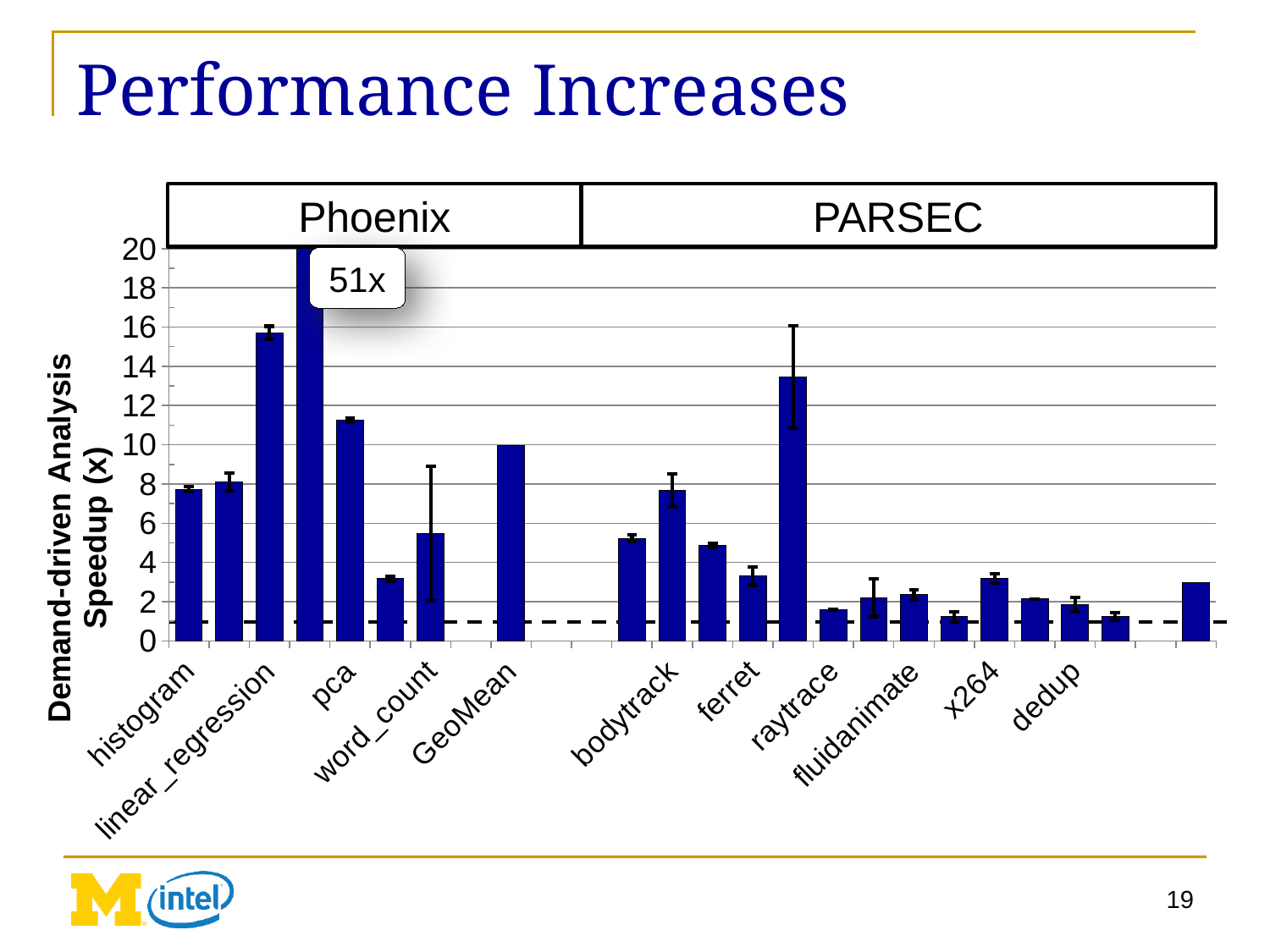
Which has the larger speedup, histogram or ferret? histogram What kind of chart is shown on the slide? bar chart Is the value for x264 greater or less than 4? less Which benchmark group, Phoenix or PARSEC, contains the bar annotated 51x? Phoenix Which has the larger speedup, linear_regression or pca? linear_regression Is the value for linear_regression greater or less than 14? greater Is the value for GeoMean greater or less than 8? greater What is the label of the y axis? Demand-driven Analysis Speedup (x) What value is annotated for the tallest bar in the chart? 51x